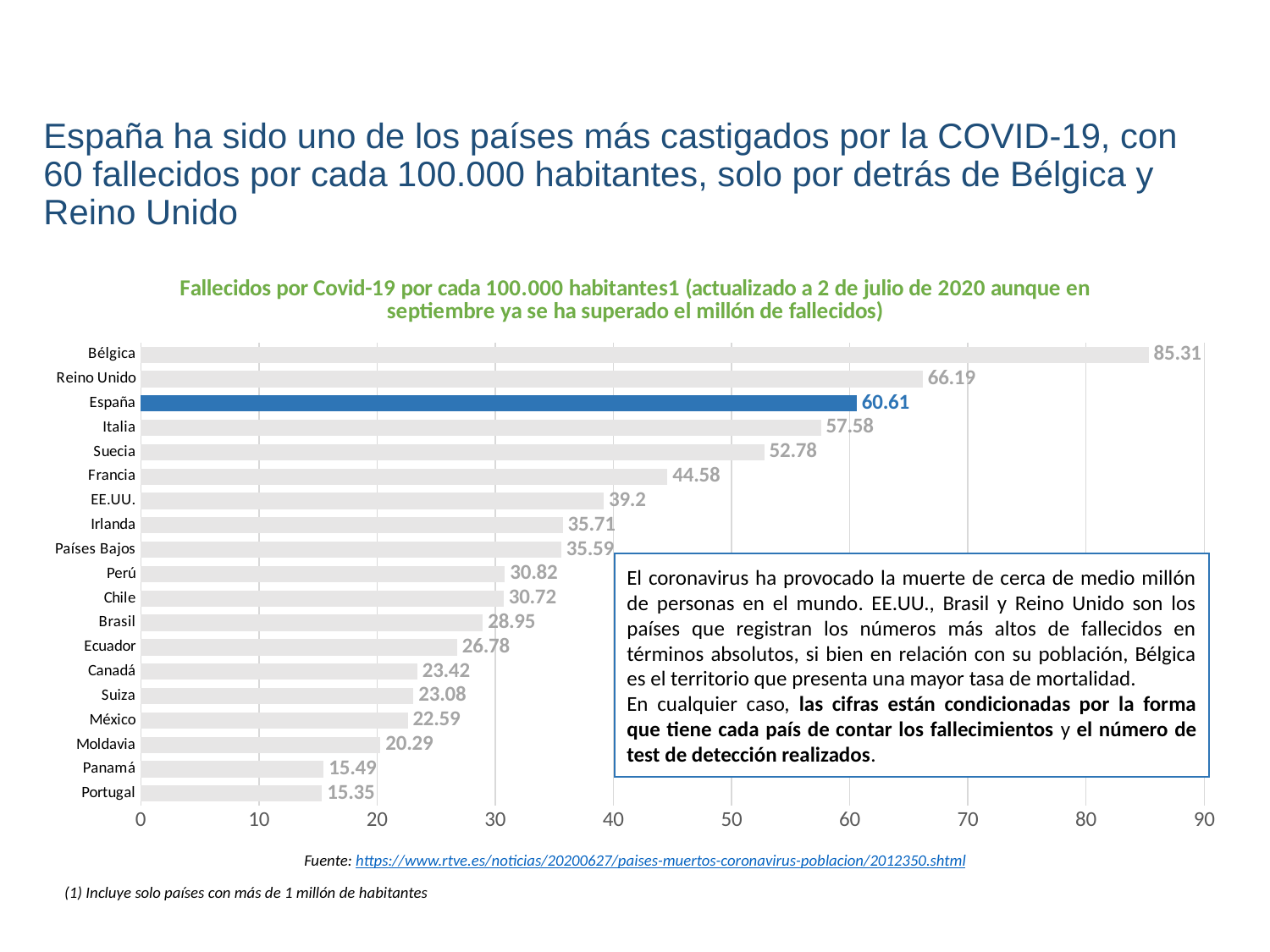
What is the value for Moldavia? 20.29 Is the value for Suecia greater or less than 50? greater What is the value for España? 60.61 Which bar is highlighted in blue in the chart? España What is the difference between the values for Bélgica and Reino Unido? 19.12 What is the value for Bélgica? 85.31 How many countries are shown in the chart? 19 What is the value for Portugal? 15.35 Which has a larger value, Francia or EE.UU.? Francia What kind of chart is shown on the slide? Bar chart Which country has the lowest value? Portugal Which country has the highest value? Bélgica